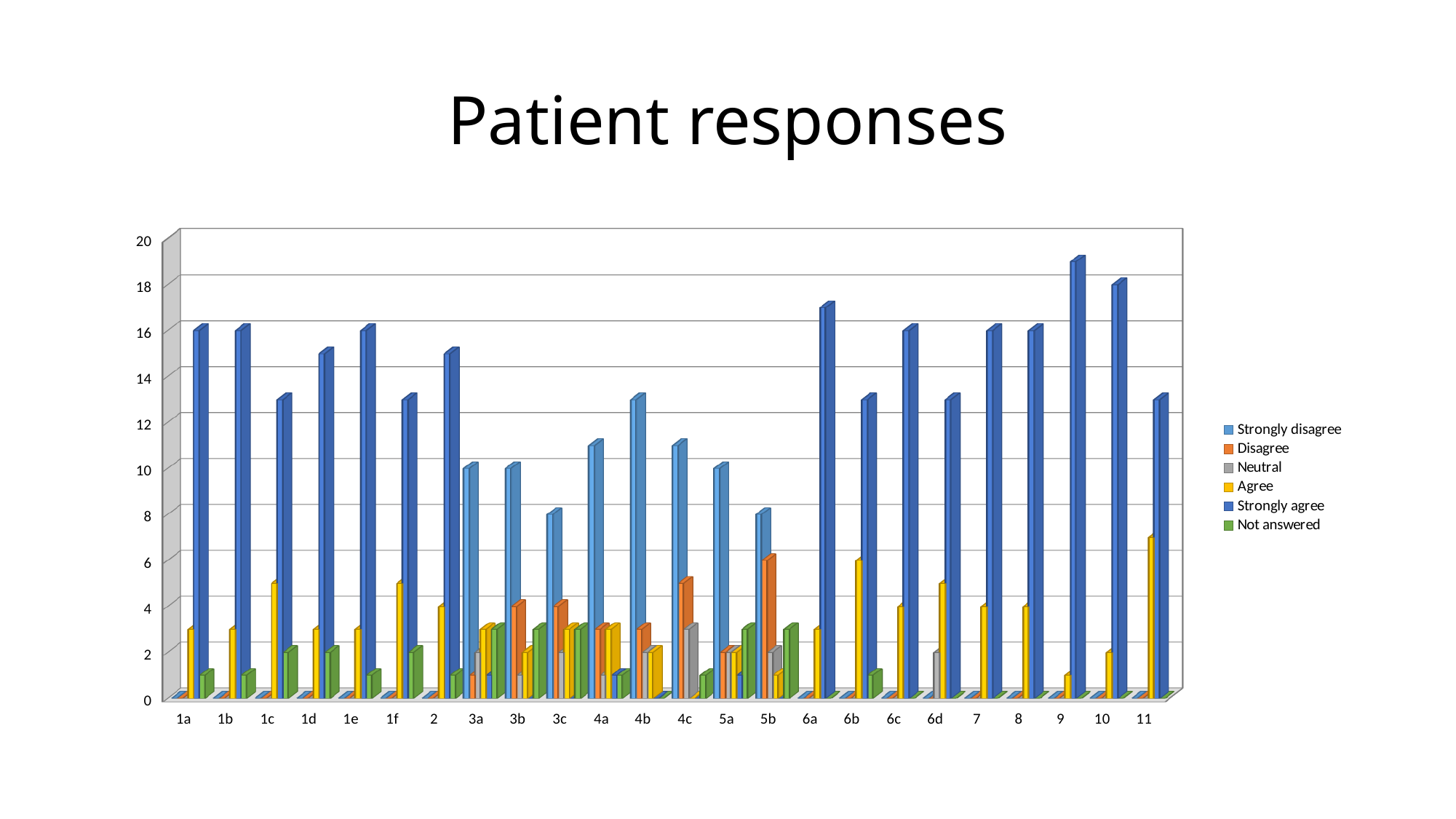
Which category has the highest Strongly disagree value? 4b What is the title of the chart? Patient responses Which is larger, the Strongly disagree value for 4b or for 3c? 4b How many categories are shown along the x axis? 24 Is the Strongly agree value for 3b greater or less than 4? less Is the Strongly disagree value for 4b greater or less than 10? greater Which is larger, the Strongly agree value for 1a or for 1c? 1a Which category has the highest Agree value? 11 Is the Strongly agree value for 9 greater or less than 16? greater How many series does the legend list? 6 What kind of chart is shown on the slide? Bar chart Which category has the highest Strongly agree value? 9